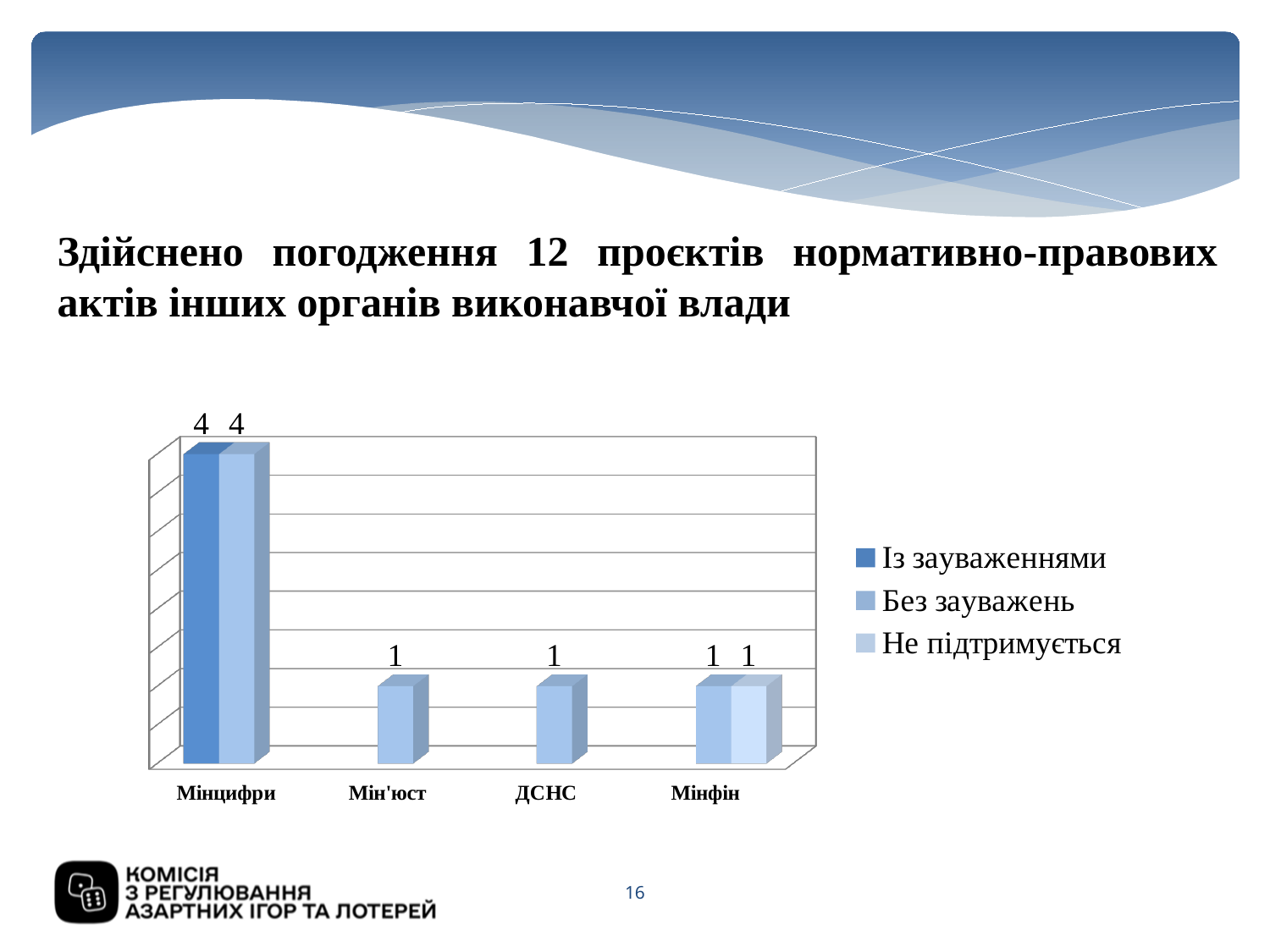
What is the total of the Без зауважень values across all four categories? 7 How many categories are shown on the x axis? 4 Which is larger: the Без зауважень value for Мінцифри or for Мінфін? Мінцифри What kind of chart is shown on the slide? bar chart What is the value for Мін'юст in the Без зауважень series? 1 What is the value for Мінфін in the Не підтримується series? 1 Which category has the highest value in the Без зауважень series? Мінцифри What is the value for Мінцифри in the Із зауваженнями series? 4 Which category is the only one with a bar in the Із зауваженнями series? Мінцифри What is the difference between the Без зауважень values for Мінцифри and ДСНС? 3 What is the value for Мінцифри in the Без зауважень series? 4 How many series does the legend list? 3